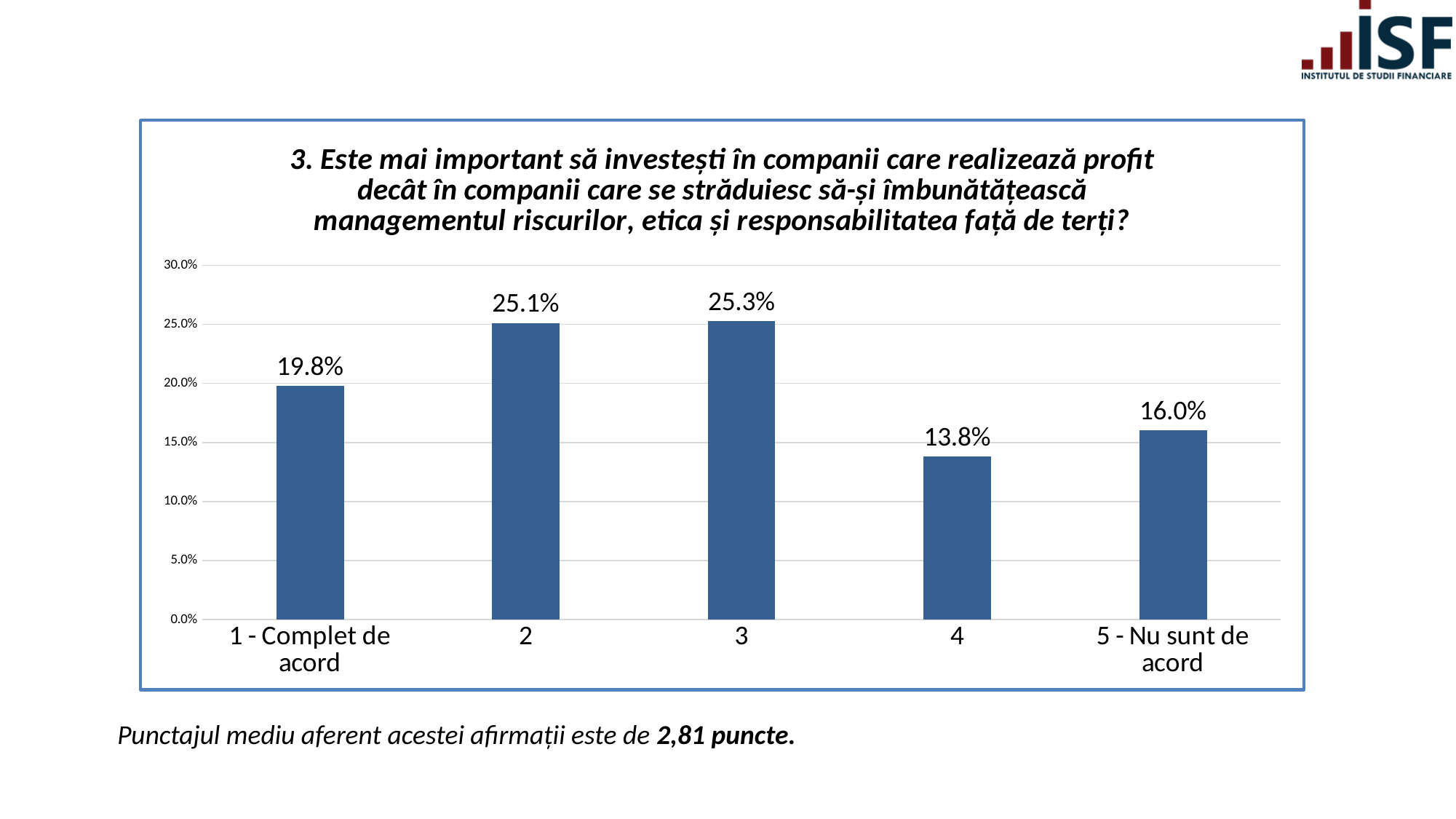
What kind of chart is shown on the slide? bar chart Which category has the lowest value? 4 What is the value for category 4? 13.8% Which is larger, the value for "1 - Complet de acord" or the value for "5 - Nu sunt de acord"? 1 - Complet de acord What is the value for category 2? 25.1% Is the value for category 4 greater or less than 15.0%? less What is the difference between the values for category 3 and category 4? 11.5% How many categories are shown on the x axis? 5 What is the value for category "5 - Nu sunt de acord"? 16.0% What is the value for category "1 - Complet de acord"? 19.8% What is the difference between the values for category 2 and category "1 - Complet de acord"? 5.3% What is the average score stated below the chart for this statement? 2,81 puncte